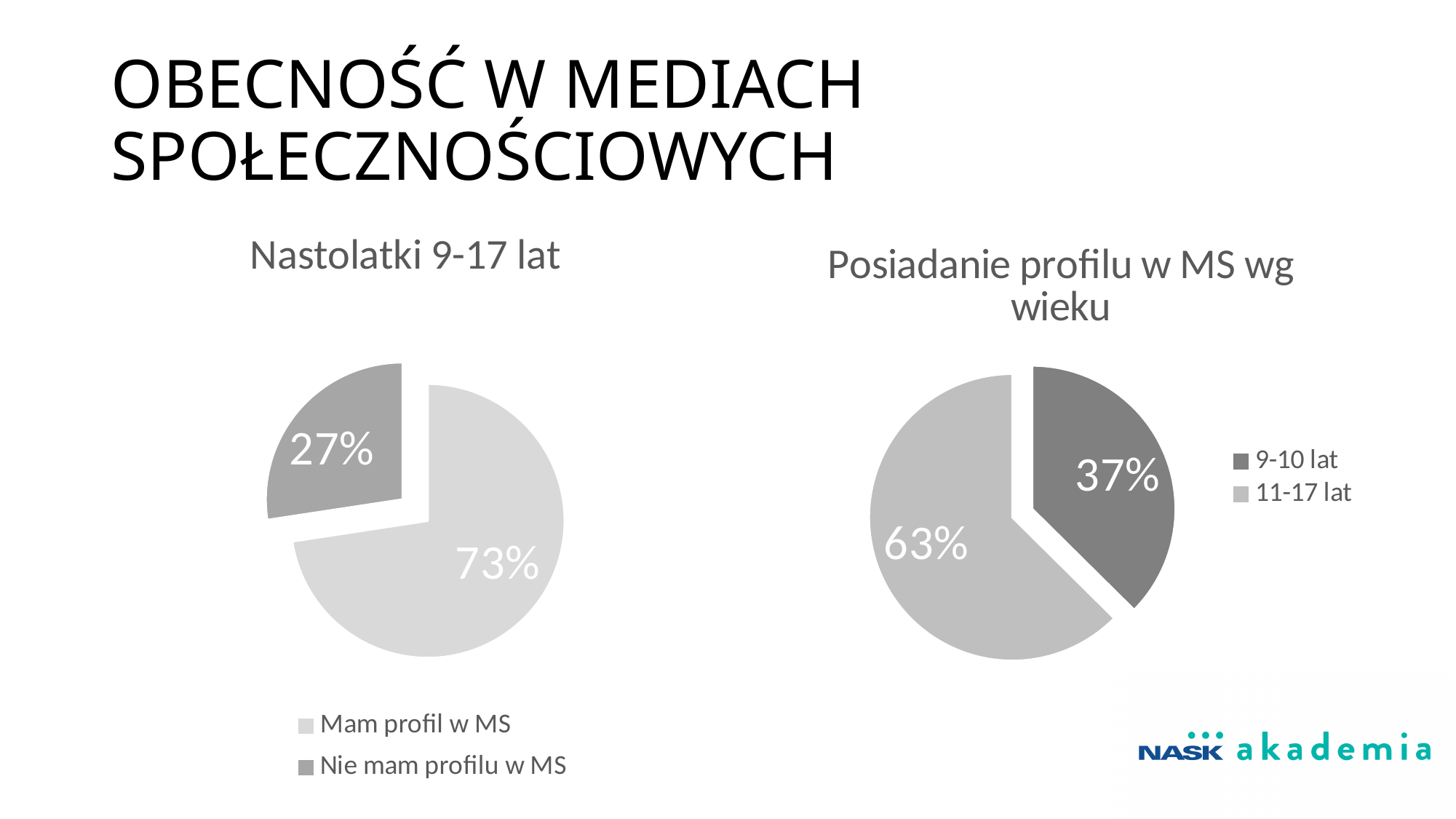
In the 'Posiadanie profilu w MS wg wieku' chart, how many entries does the legend list? 2 In the 'Nastolatki 9-17 lat' chart, what are the two legend entries? Mam profil w MS; Nie mam profilu w MS In the 'Nastolatki 9-17 lat' chart, how many slices does the pie have? 2 What kind of chart is the 'Nastolatki 9-17 lat' chart? Pie chart In the 'Posiadanie profilu w MS wg wieku' chart, what share is labelled for '9-10 lat'? 37% In the 'Nastolatki 9-17 lat' chart, what share is labelled for 'Mam profil w MS'? 73% In the 'Nastolatki 9-17 lat' chart, which slice is the largest? Mam profil w MS In the 'Nastolatki 9-17 lat' chart, what is the difference between the 'Mam profil w MS' and 'Nie mam profilu w MS' shares? 46% In the 'Posiadanie profilu w MS wg wieku' chart, which is larger: '9-10 lat' or '11-17 lat'? 11-17 lat In the 'Posiadanie profilu w MS wg wieku' chart, which slice is the smallest? 9-10 lat In the 'Nastolatki 9-17 lat' chart, what share is labelled for 'Nie mam profilu w MS'? 27% In the 'Posiadanie profilu w MS wg wieku' chart, what share is labelled for '11-17 lat'? 63%